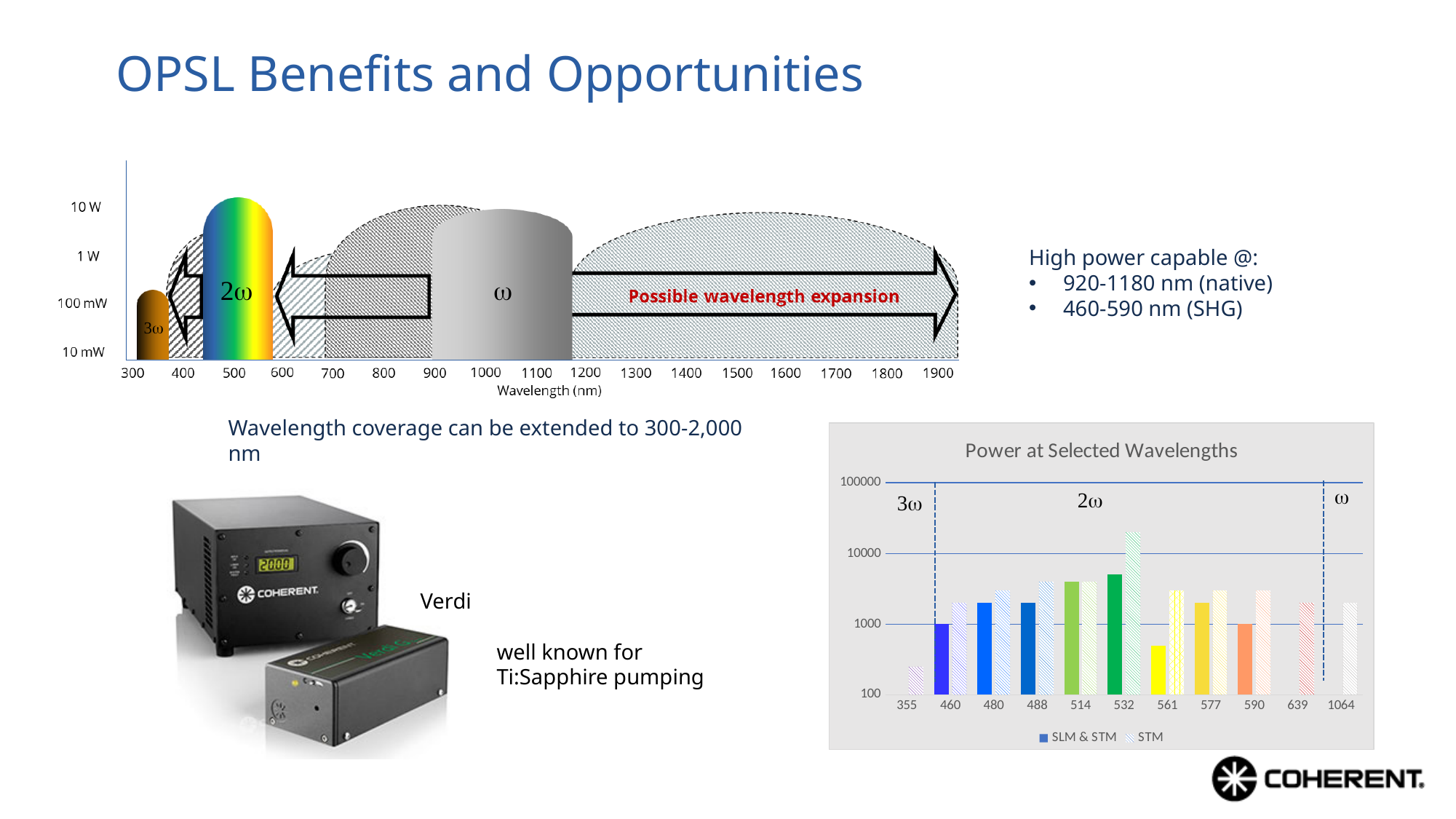
In the "Power at Selected Wavelengths" chart, which wavelength has the highest STM bar? 532 In the "Power at Selected Wavelengths" chart, is the SLM & STM value at 561 greater or less than 1000? less What is the title of the bar chart on the lower right of the slide? Power at Selected Wavelengths How many wavelength categories are shown on the x axis of the "Power at Selected Wavelengths" chart? 11 In the "Power at Selected Wavelengths" chart, is the STM value at 532 greater or less than 10000? greater In the "Power at Selected Wavelengths" chart, which wavelength has the lowest STM bar? 355 In the "Power at Selected Wavelengths" chart, which is larger, the SLM & STM value at 532 or at 561? 532 In the "Power at Selected Wavelengths" chart, is the SLM & STM value at 514 greater or less than 1000? greater What are the two legend entries in the "Power at Selected Wavelengths" chart? SLM & STM and STM How many series does the legend of the "Power at Selected Wavelengths" chart list? 2 What kind of chart is "Power at Selected Wavelengths"? bar chart